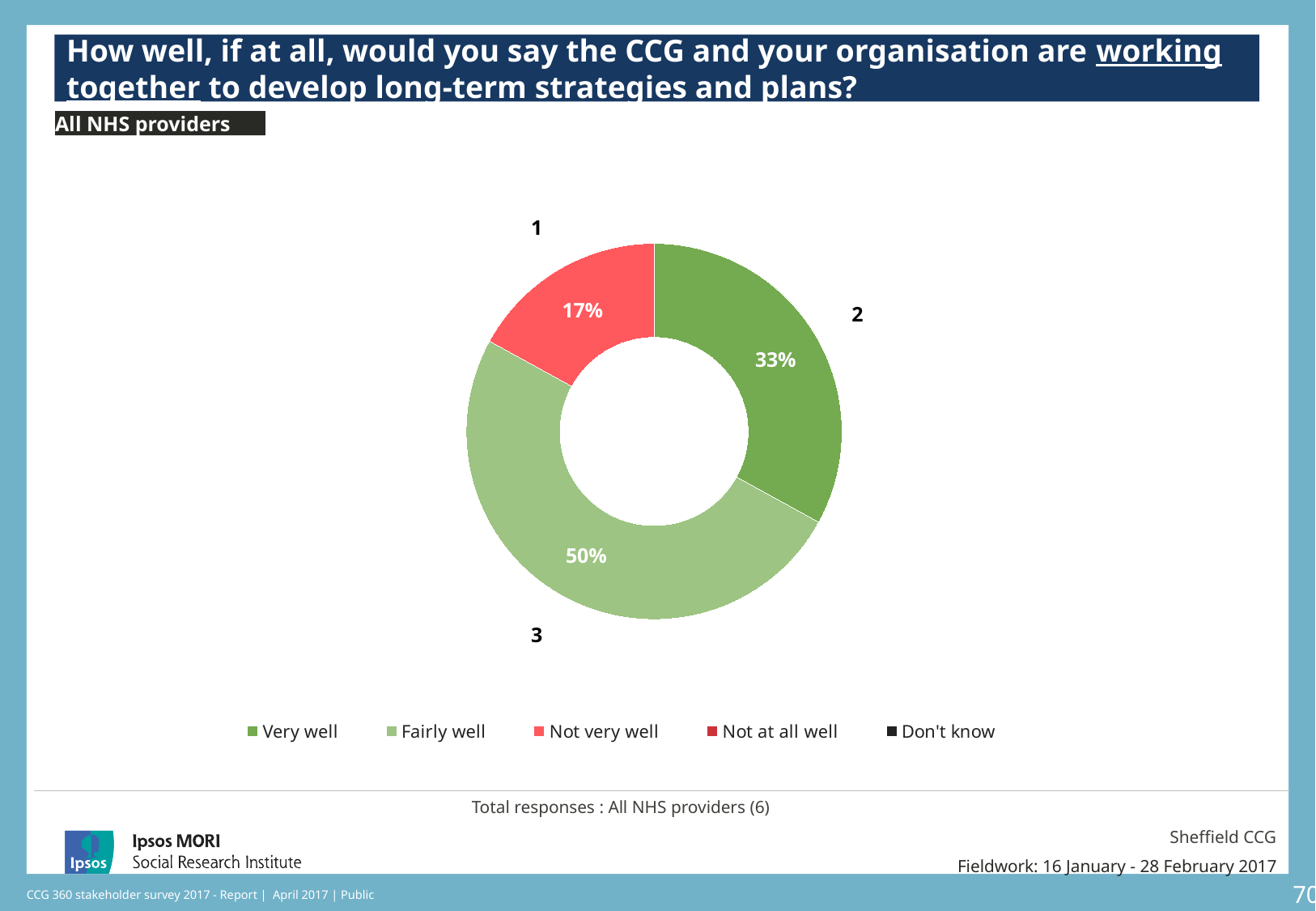
What percentage of respondents answered 'Not very well'? 17% How many response categories does the legend list? 5 What type of chart is shown on the slide? Donut (pie) chart What percentage of respondents answered 'Very well'? 33% Which response category has the largest share of the chart? Fairly well What colour is used for the 'Not very well' slice? Red How many slices are plotted on the chart? 3 What percentage of respondents said the CCG and their organisation are working together 'Fairly well'? 50% Which response category shown on the chart has the smallest share? Not very well What is the combined share of 'Very well' and 'Fairly well'? 83% What is the difference in percentage points between 'Fairly well' and 'Very well'? 17 Which is larger, the share for 'Very well' or the share for 'Not very well'? Very well